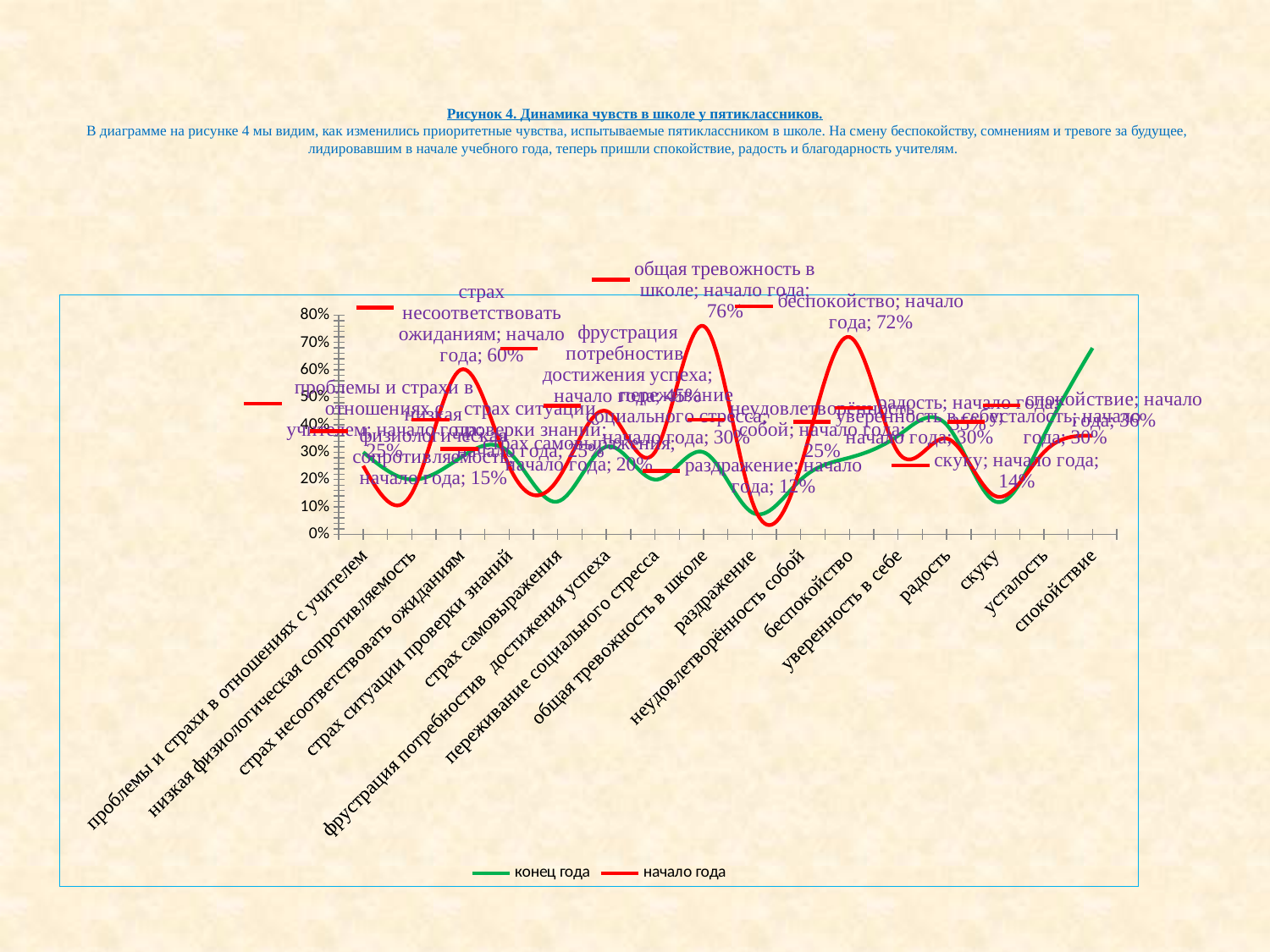
What is the value for "общая тревожность в школе" in the "начало года" series? 76% What is the value for "страх несоответствовать ожиданиям" in the "начало года" series? 60% How many categories are shown along the x axis? 16 What is the value for "скуку" in the "начало года" series? 14% What is the value for "беспокойство" in the "начало года" series? 72% What kind of chart is shown on the slide? line chart Which category has the highest value in the "начало года" series? общая тревожность в школе Which colour is used for the "начало года" series? red How many series does the legend list? 2 What is the value for "раздражение" in the "начало года" series? 12% Is the "конец года" value for "спокойствие" greater or less than 50%? greater What is the difference between the "начало года" values for "общая тревожность в школе" and "беспокойство"? 4%